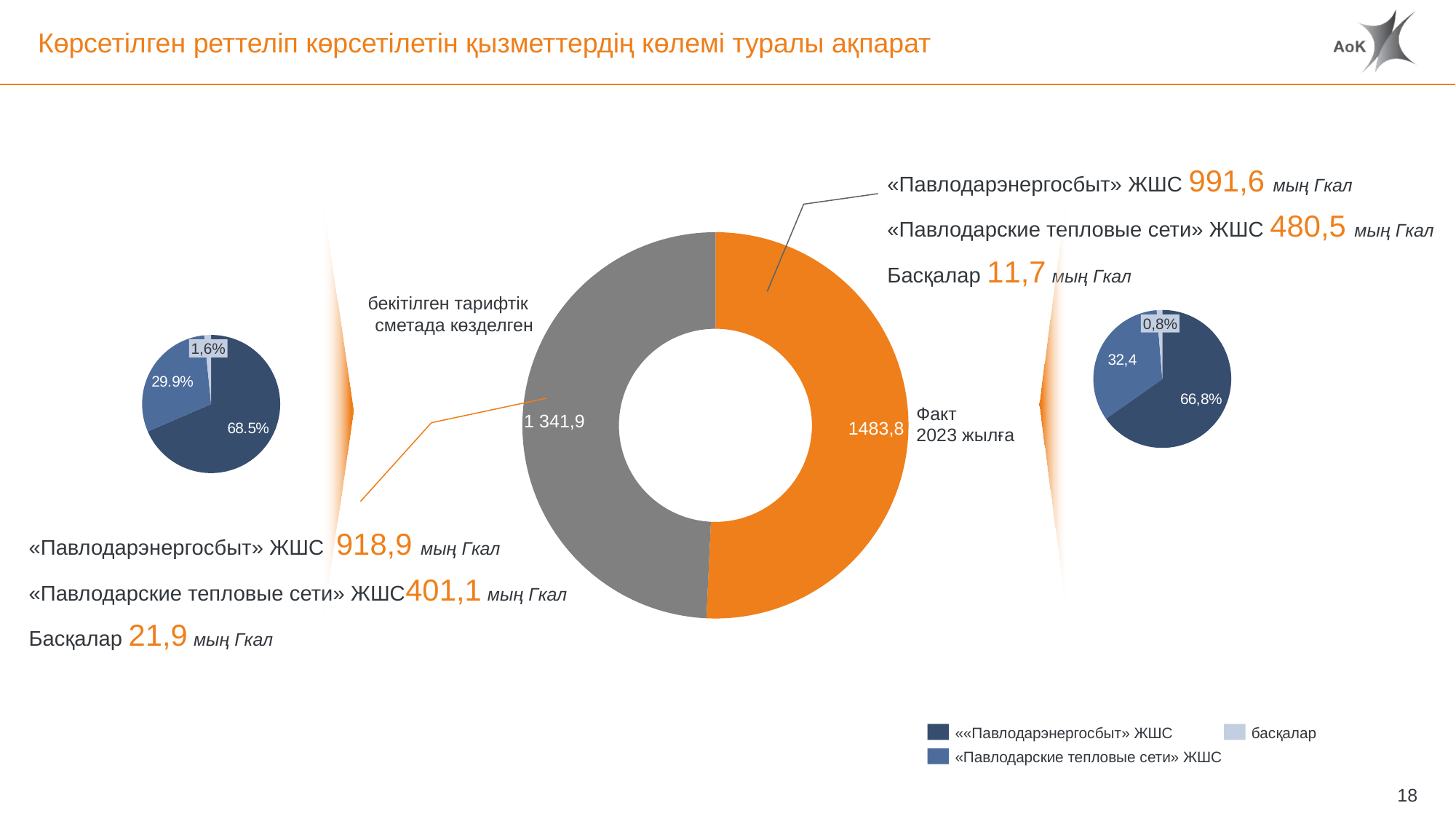
How many segments does the central donut chart have? 2 How many slices does the right pie chart have? 3 On the right pie chart, what is the smallest slice's value? 0,8% On the right pie chart, what is the largest slice's value? 66,8% On the central donut chart, what value is shown for the segment labelled 'Факт 2023 жылға'? 1483,8 How many entries does the legend at the bottom of the slide list? 3 On the central donut chart, what is the difference between the 'Факт 2023 жылға' value and the 'бекітілген тарифтік сметада көзделген' value? 141,9 On the left pie chart, what is the largest slice's value? 68.5% On the left pie chart, what is the smallest slice's value? 1,6% On the central donut chart, what value is shown for the segment labelled 'бекітілген тарифтік сметада көзделген'? 1 341,9 On the central donut chart, which segment is larger: 'Факт 2023 жылға' or 'бекітілген тарифтік сметада көзделген'? Факт 2023 жылға What kind of chart is the chart on the left of the slide? Pie chart